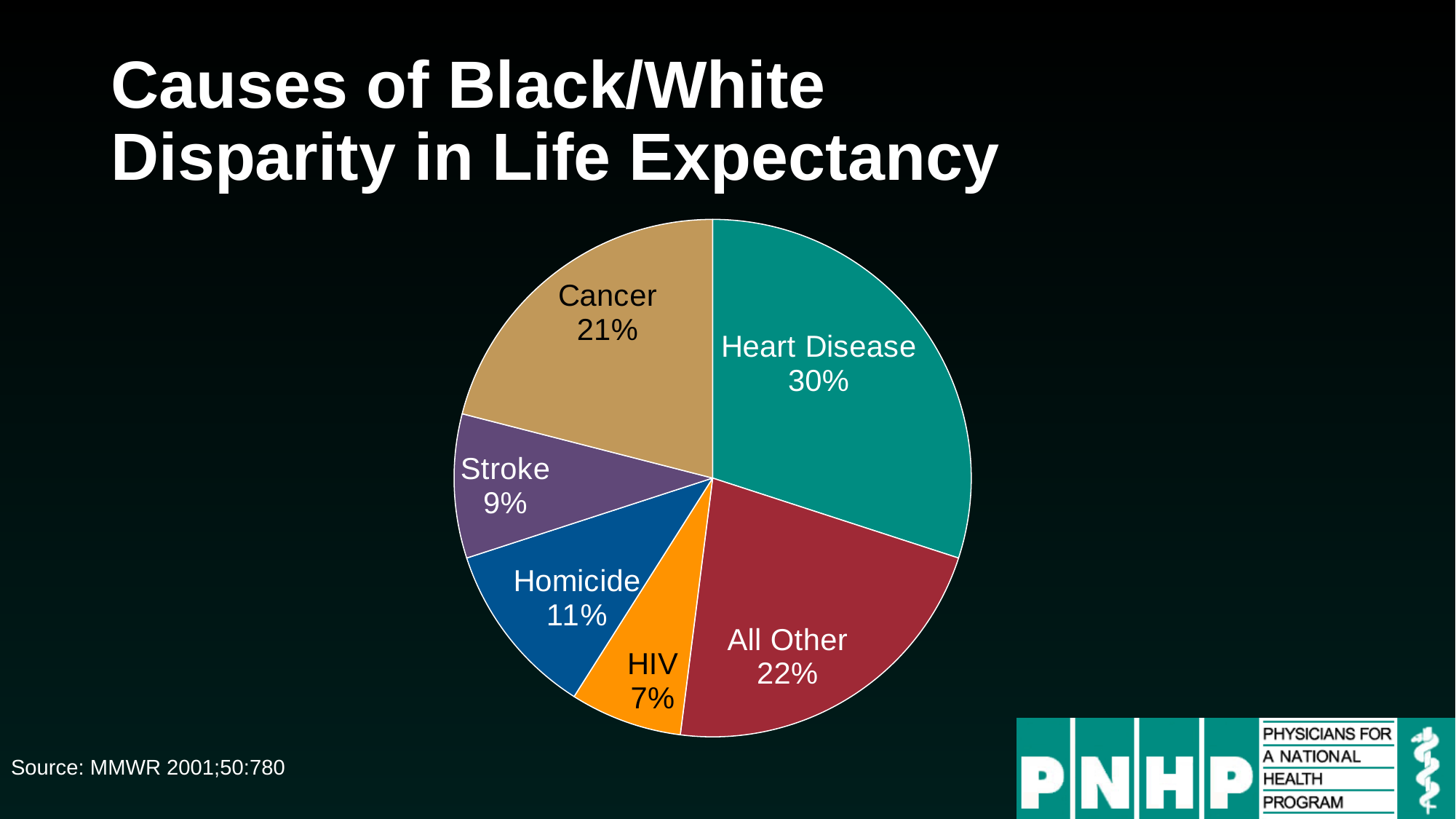
What kind of chart is shown on the slide? Pie chart Which is larger, the share for Stroke or the share for Homicide? Homicide What is the title of the chart on the slide? Causes of Black/White Disparity in Life Expectancy Which cause has the largest slice of the pie? Heart Disease Which cause has the smallest slice of the pie? HIV What share of the Black/White disparity in life expectancy is attributed to Heart Disease? 30% What is the combined share of Stroke and HIV? 16% What percentage is shown for HIV? 7% How many slices does the pie chart have? 6 What percentage is shown for Cancer? 21% What percentage is shown for Homicide? 11% What is the difference in percentage points between Heart Disease and Cancer? 9